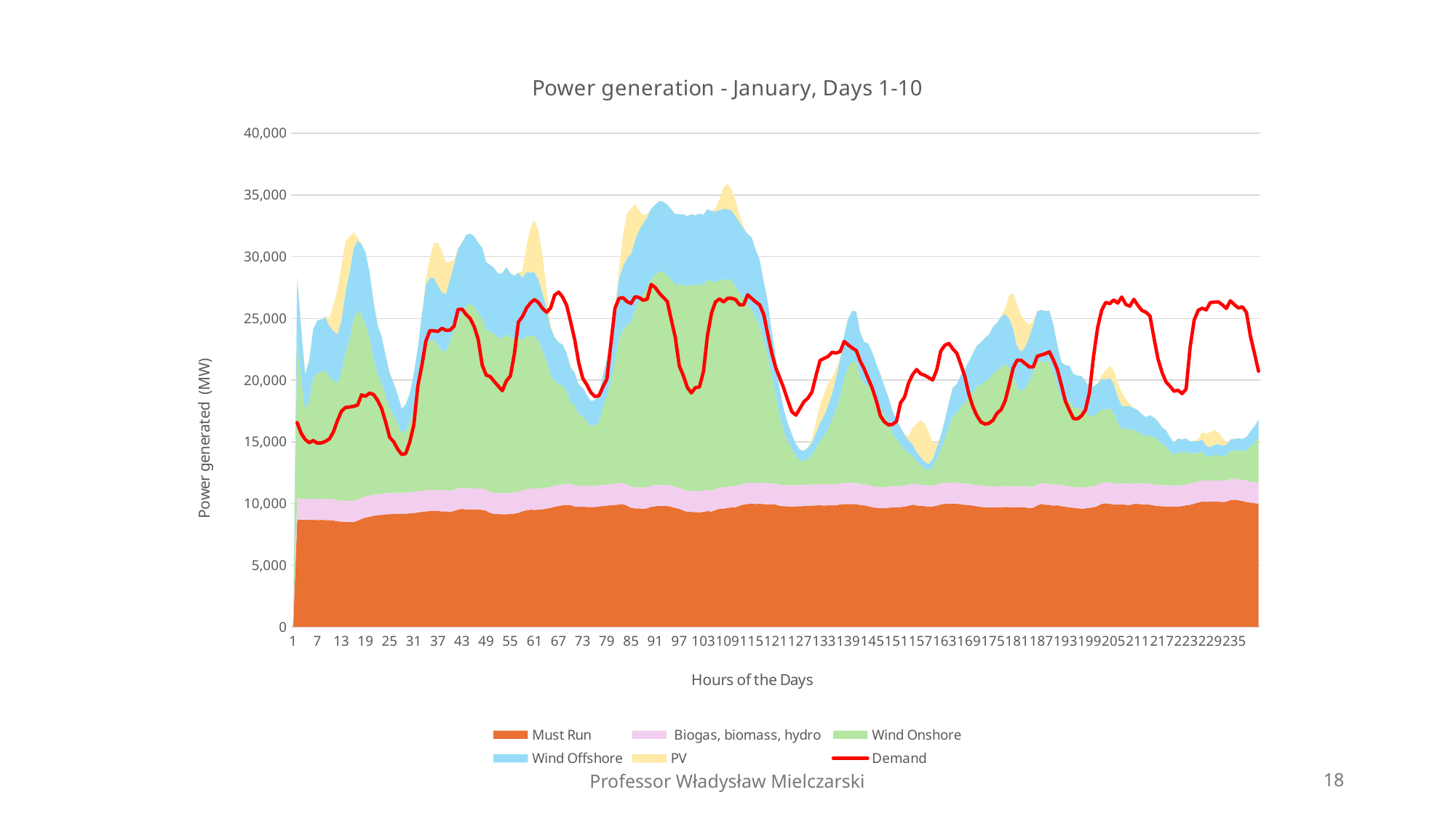
Is the Demand value at hour 205 greater or less than 25,000? greater Is the Demand value at hour 91 greater or less than 25,000? greater Is the Demand value at hour 31 greater or less than 15,000? greater How many series does the legend list? 6 Which series is drawn as a red line rather than a filled area? Demand What is the title of the chart? Power generation - January, Days 1-10 What kind of chart is shown on the slide? stacked area chart with a line